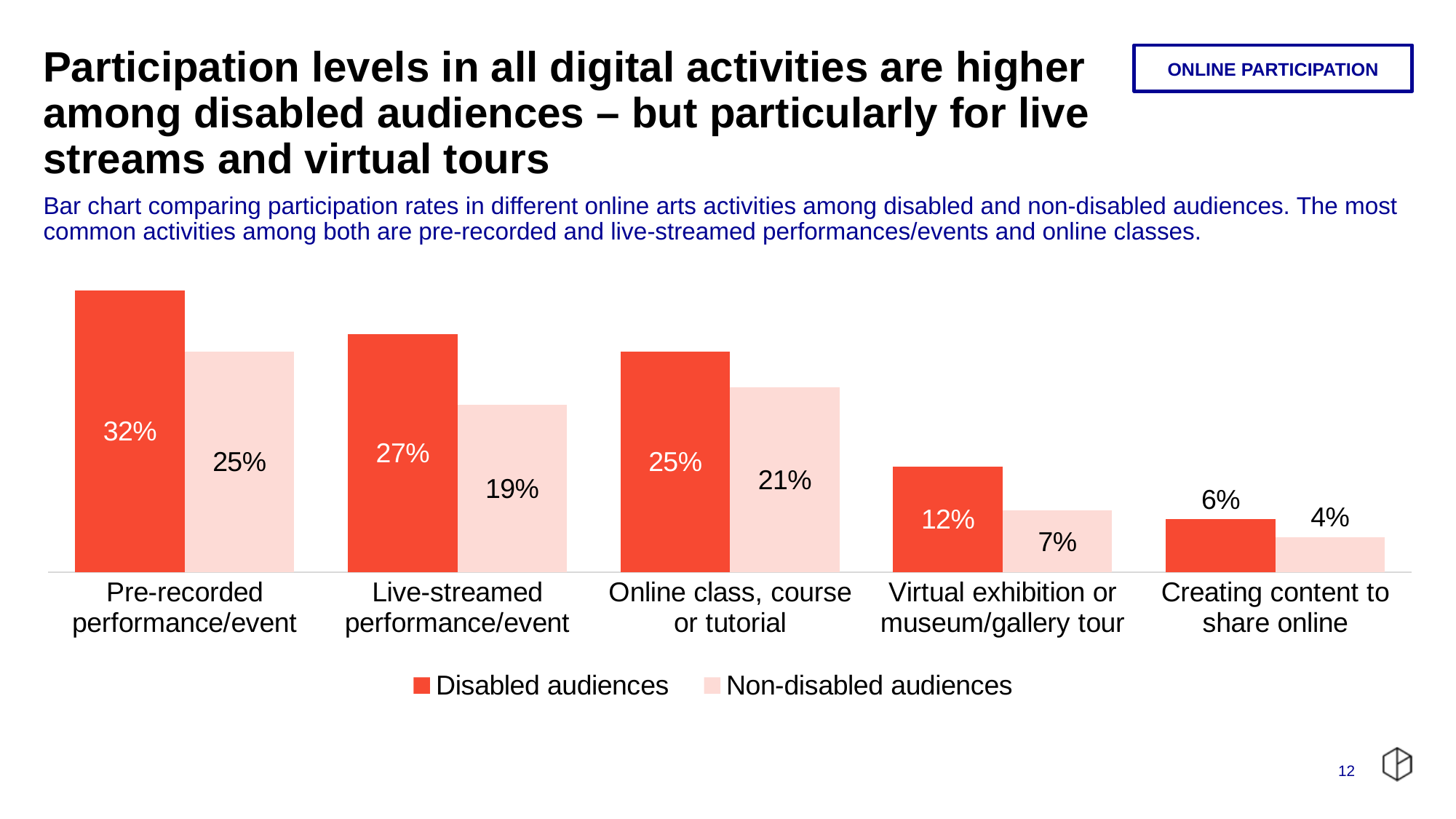
Which activity has the lowest participation rate among non-disabled audiences? Creating content to share online What kind of chart is shown on the slide? Bar chart What is the difference between disabled and non-disabled audiences' participation in virtual exhibition or museum/gallery tour? 5 percentage points Which activity has the highest participation rate among disabled audiences? Pre-recorded performance/event What is the participation rate for disabled audiences in virtual exhibition or museum/gallery tour? 12% How many series does the legend list? 2 What is the participation rate for disabled audiences in pre-recorded performance/event? 32% What is the difference between disabled and non-disabled audiences' participation in live-streamed performance/event? 8 percentage points Which is larger: the non-disabled audiences' rate for online class, course or tutorial, or the non-disabled audiences' rate for live-streamed performance/event? Online class, course or tutorial What is the participation rate for non-disabled audiences in live-streamed performance/event? 19% How many activity categories are shown on the chart? 5 Do the disabled audiences' values rise or fall from left to right across the categories? Fall